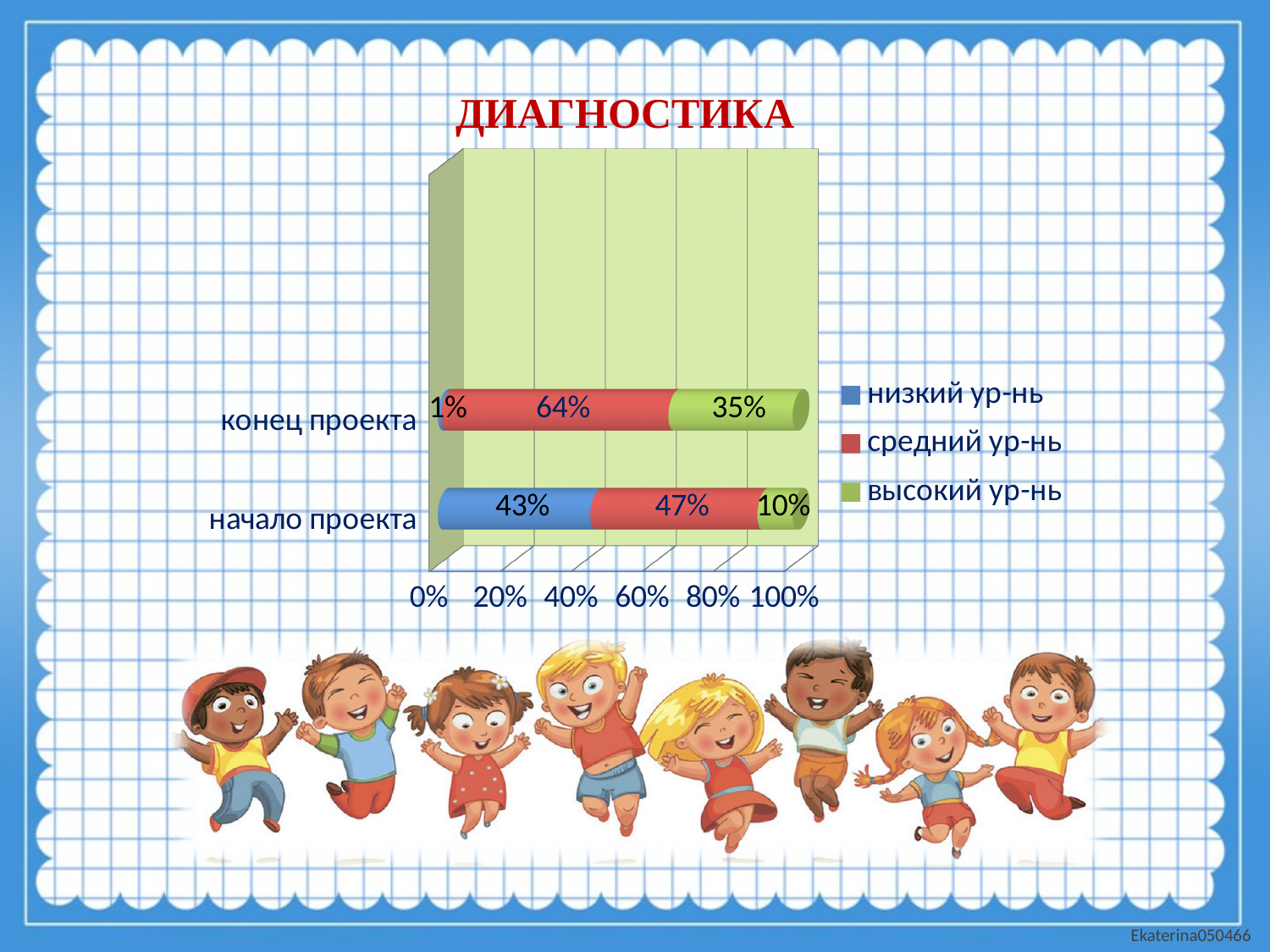
What is the difference between the высокий ур-нь values for конец проекта and начало проекта? 25% How many categories are shown on the chart? 2 Which series has the smallest value in the начало проекта bar? высокий ур-нь What is the value for низкий ур-нь in the начало проекта bar? 43% Which series has the largest value in the конец проекта bar? средний ур-нь What is the value for высокий ур-нь in the начало проекта bar? 10% Which is larger: the средний ур-нь value for начало проекта or for конец проекта? конец проекта How many series does the legend list? 3 What is the title of the chart? ДИАГНОСТИКА What is the value for средний ур-нь in the конец проекта bar? 64% What kind of chart is shown on the slide? stacked bar chart What is the value for низкий ур-нь in the конец проекта bar? 1%